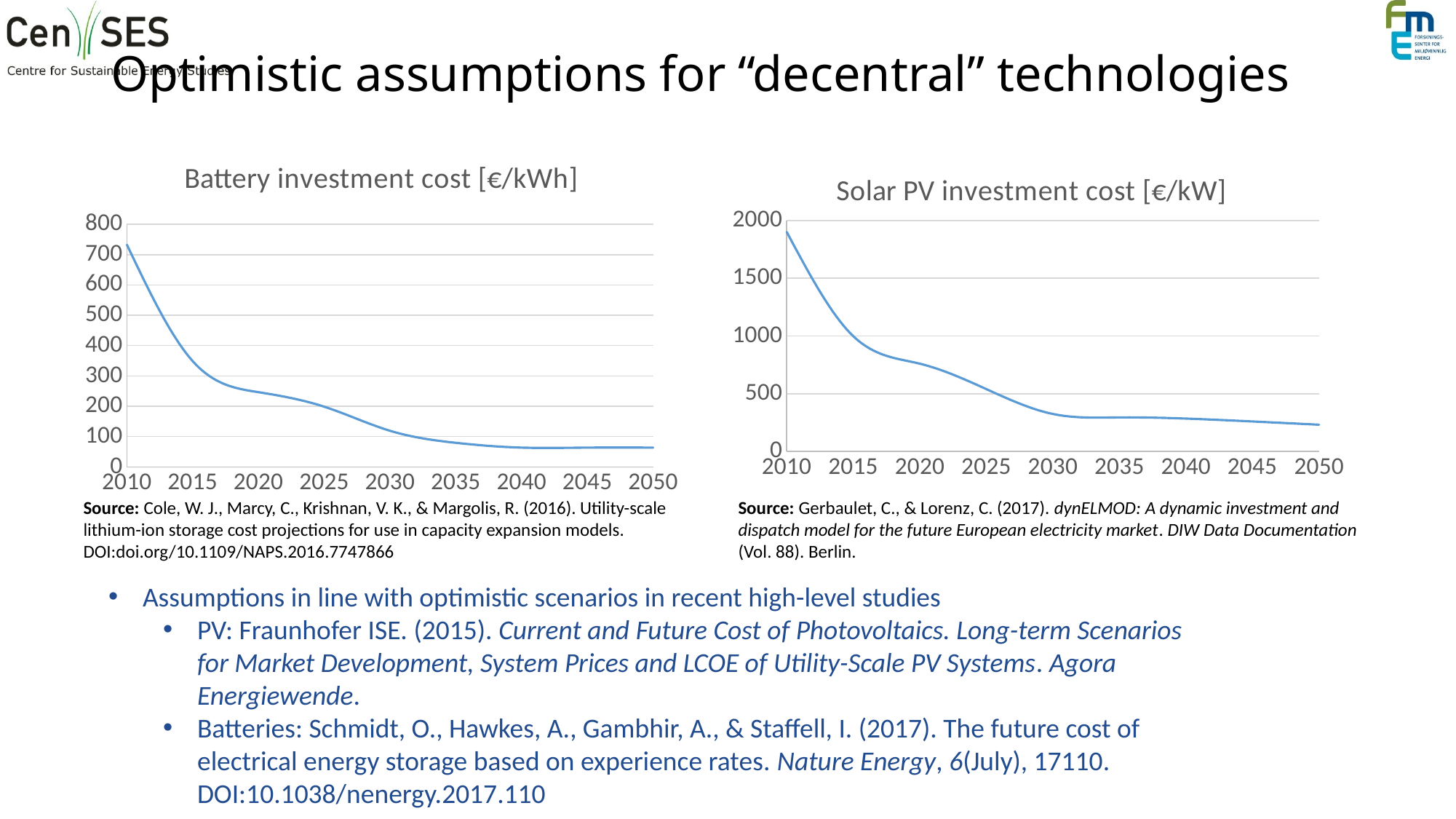
In the "Solar PV investment cost [€/kW]" chart, do the values rise or fall from 2010 to 2050? fall What is the title of the chart on the right side of the slide? Solar PV investment cost [€/kW] In the "Battery investment cost [€/kWh]" chart, is the value for 2050 greater or less than 100? less In the "Solar PV investment cost [€/kW]" chart, which year has the highest value? 2010 In the "Battery investment cost [€/kWh]" chart, do the values rise or fall from 2010 to 2050? fall What kind of chart is the "Solar PV investment cost [€/kW]" chart? line chart What kind of chart is the "Battery investment cost [€/kWh]" chart? line chart In the "Solar PV investment cost [€/kW]" chart, is the value for 2030 greater or less than 500? less In the "Solar PV investment cost [€/kW]" chart, is the value for 2010 greater or less than 1500? greater In the "Battery investment cost [€/kWh]" chart, which is larger, the value for 2010 or the value for 2030? 2010